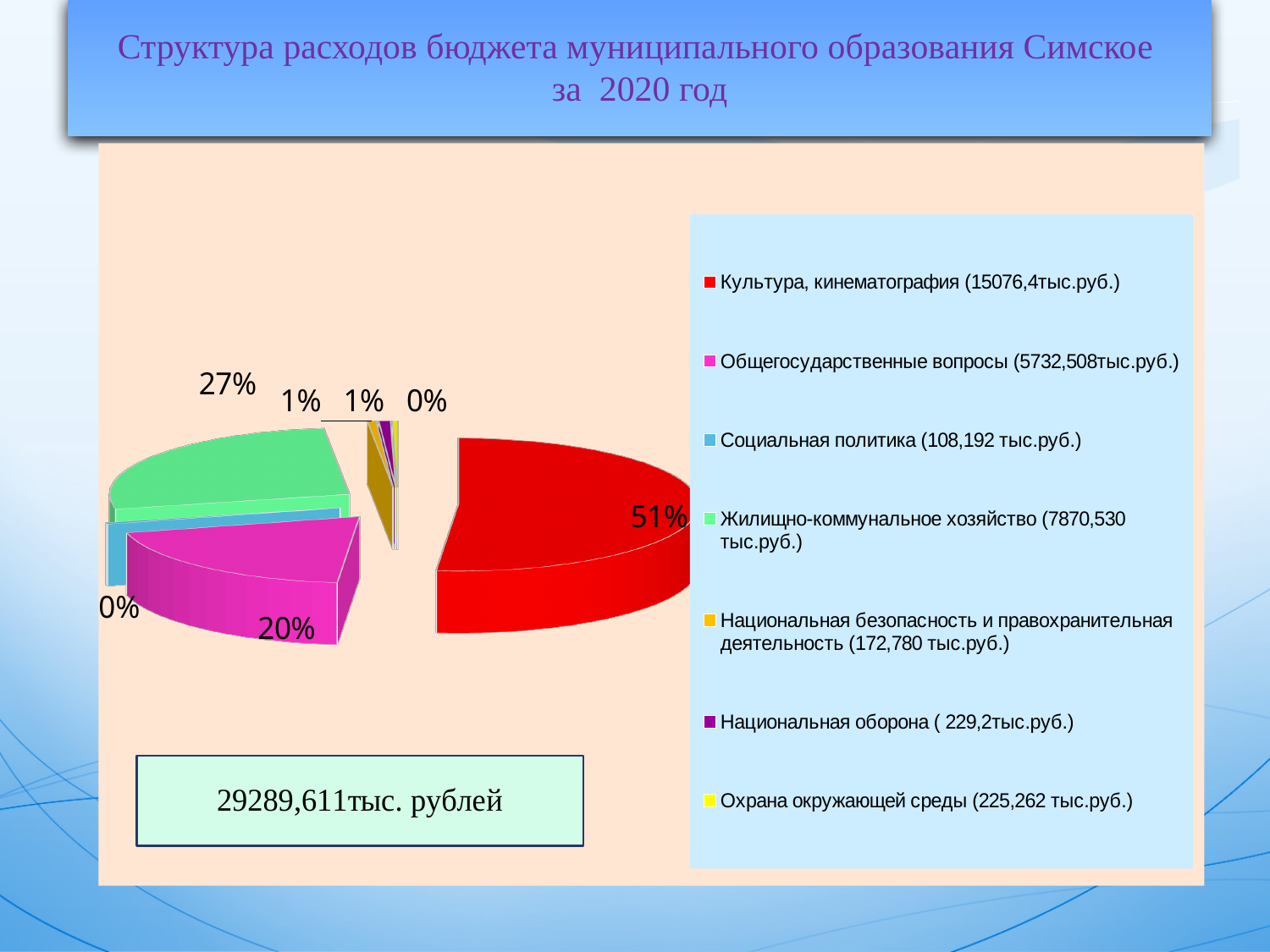
What share of the pie does Социальная политика have? 0% What share of the pie does Общегосударственные вопросы have? 20% What total amount is shown in the box below the pie chart? 29289,611тыс. рублей Which category has the largest slice of the pie? Культура, кинематография What is the difference in percentage points between the Жилищно-коммунальное хозяйство slice and the Общегосударственные вопросы slice? 7% Which slice is larger: Жилищно-коммунальное хозяйство or Общегосударственные вопросы? Жилищно-коммунальное хозяйство How many categories does the legend list? 7 What share of the pie does Культура, кинематография have? 51% What is the difference in percentage points between the Культура, кинематография slice and the Жилищно-коммунальное хозяйство slice? 24% What amount is given in the legend for Культура, кинематография? 15076,4тыс.руб. What share of the pie does Жилищно-коммунальное хозяйство have? 27% What kind of chart is shown on the slide? pie chart